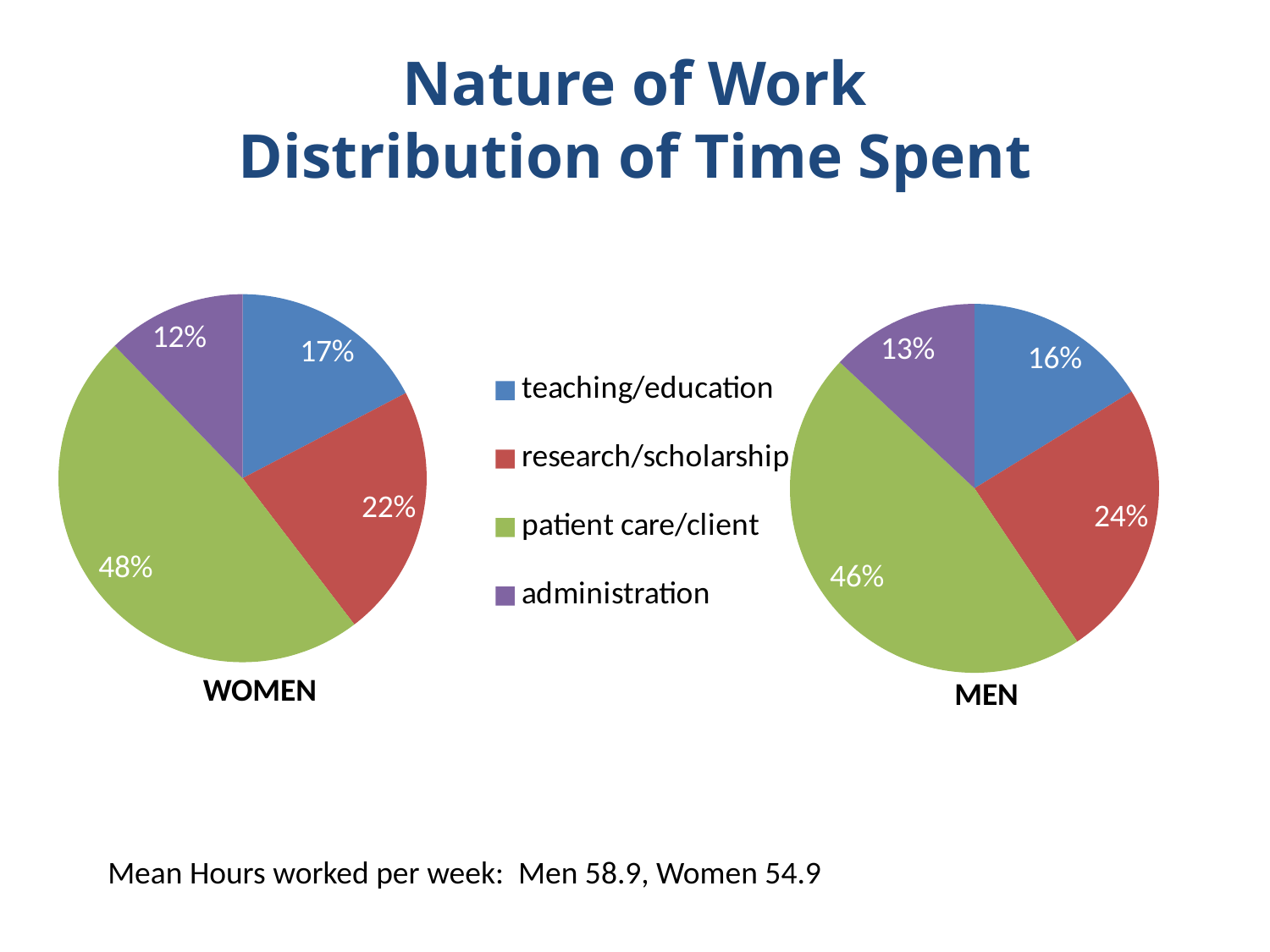
In the WOMEN pie chart, what is the difference between the patient care/client share and the research/scholarship share? 26% What type of chart is used for the WOMEN data? pie chart In the WOMEN pie chart, which category has the smallest share? administration What colour represents patient care/client in the pie charts? green In the WOMEN pie chart, what share of time is spent on administration? 12% In the MEN pie chart, which category has the largest share? patient care/client How many entries does the legend list? 4 In the MEN pie chart, what share of time is spent on research/scholarship? 24% In the WOMEN pie chart, what share of time is spent on patient care/client? 48% In the MEN pie chart, what share of time is spent on teaching/education? 16% Which is larger: the research/scholarship share in the MEN chart or in the WOMEN chart? MEN How many categories does each pie chart show? 4